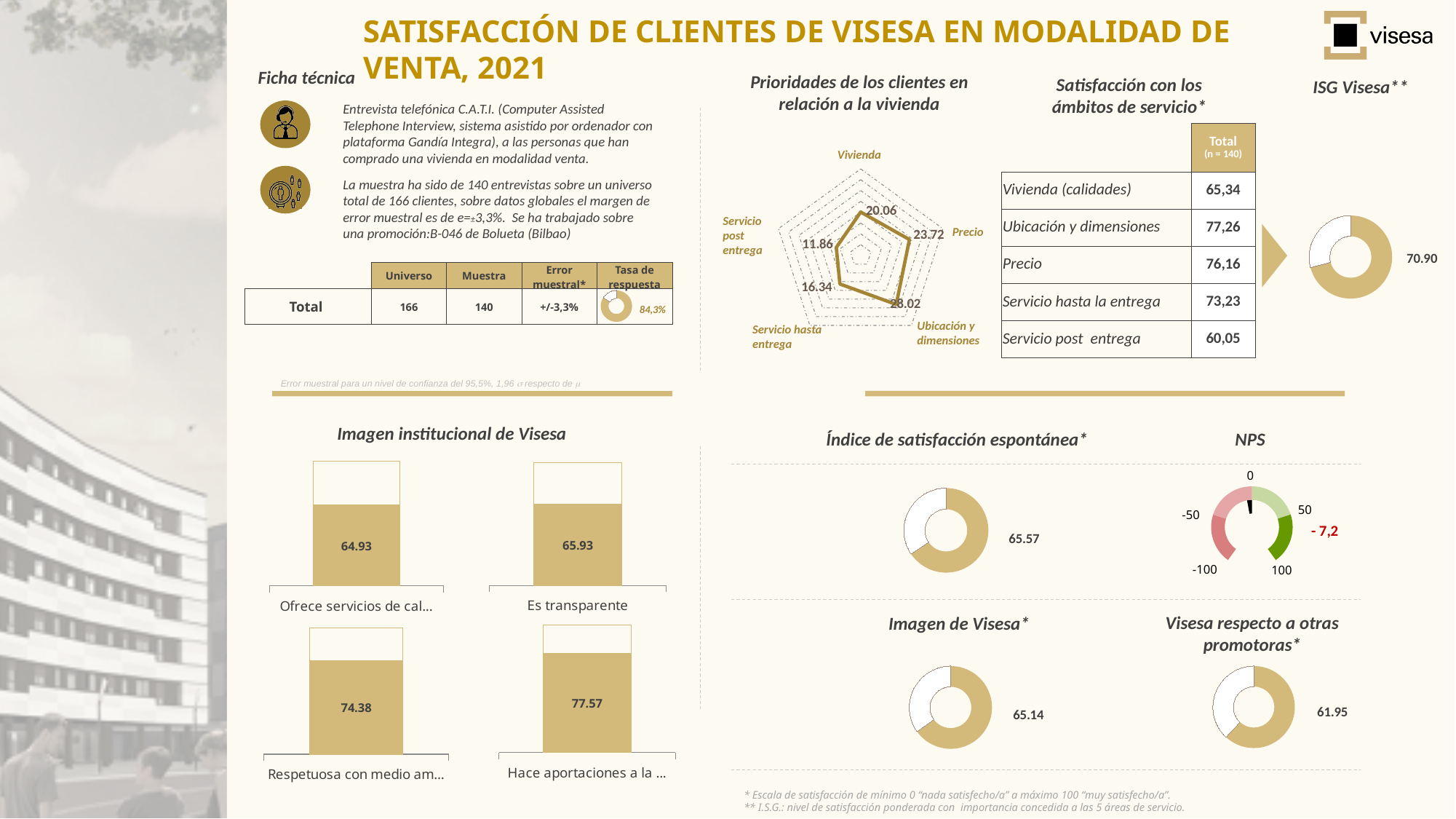
In the 'Imagen institucional de Visesa' charts, what is the value for 'Es transparente'? 65.93 In the radar chart 'Prioridades de los clientes en relación a la vivienda', which category has the lowest value? Servicio post entrega In the radar chart 'Prioridades de los clientes en relación a la vivienda', what is the value for Precio? 23.72 In the radar chart 'Prioridades de los clientes en relación a la vivienda', which category has the highest value? Ubicación y dimensiones What value is shown on the 'Índice de satisfacción espontánea' donut chart? 65.57 In the radar chart 'Prioridades de los clientes en relación a la vivienda', how many categories are plotted? 5 What value does the NPS gauge show? - 7,2 In the 'Imagen institucional de Visesa' charts, which item has the highest value? Hace aportaciones a la … What value is shown on the 'ISG Visesa' donut chart? 70.90 What value is shown on the 'Visesa respecto a otras promotoras' donut chart? 61.95 In the 'Imagen institucional de Visesa' charts, which is larger: 'Respetuosa con medio am…' or 'Ofrece servicios de cal…'? Respetuosa con medio am… In the radar chart 'Prioridades de los clientes en relación a la vivienda', what is the difference between Ubicación y dimensiones and Vivienda? 7.96